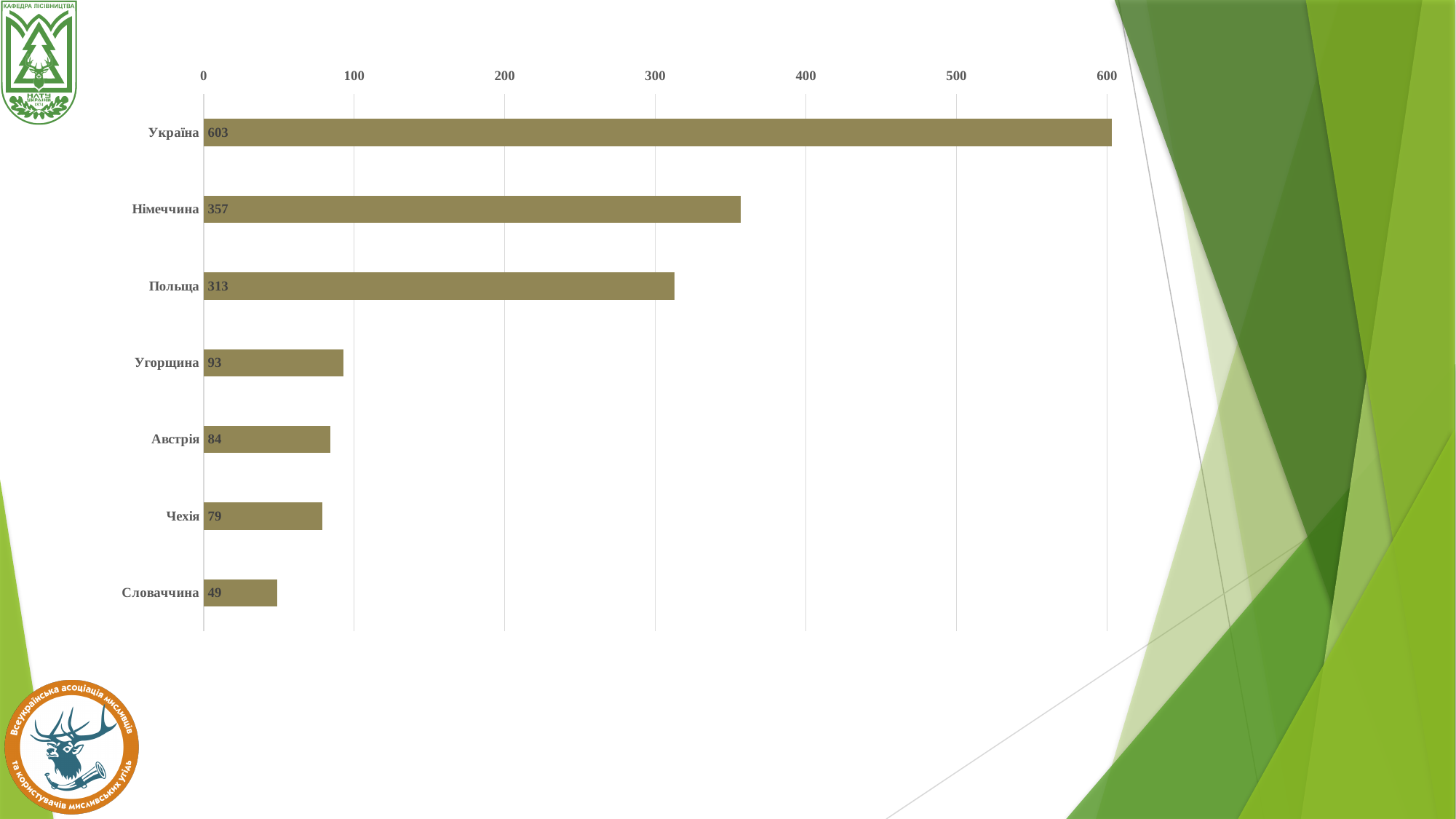
Is the value for Польща greater or less than 300? greater How many categories are shown in the chart? 7 What is the value for Словаччина? 49 What is the difference between the values for Німеччина and Польща? 44 Which is larger, the value for Угорщина or the value for Австрія? Угорщина What kind of chart is shown on the slide? bar chart What is the value for Україна? 603 What is the difference between the values for Україна and Словаччина? 554 What is the value for Німеччина? 357 Which category has the lowest value? Словаччина What is the value for Чехія? 79 Which category has the highest value? Україна